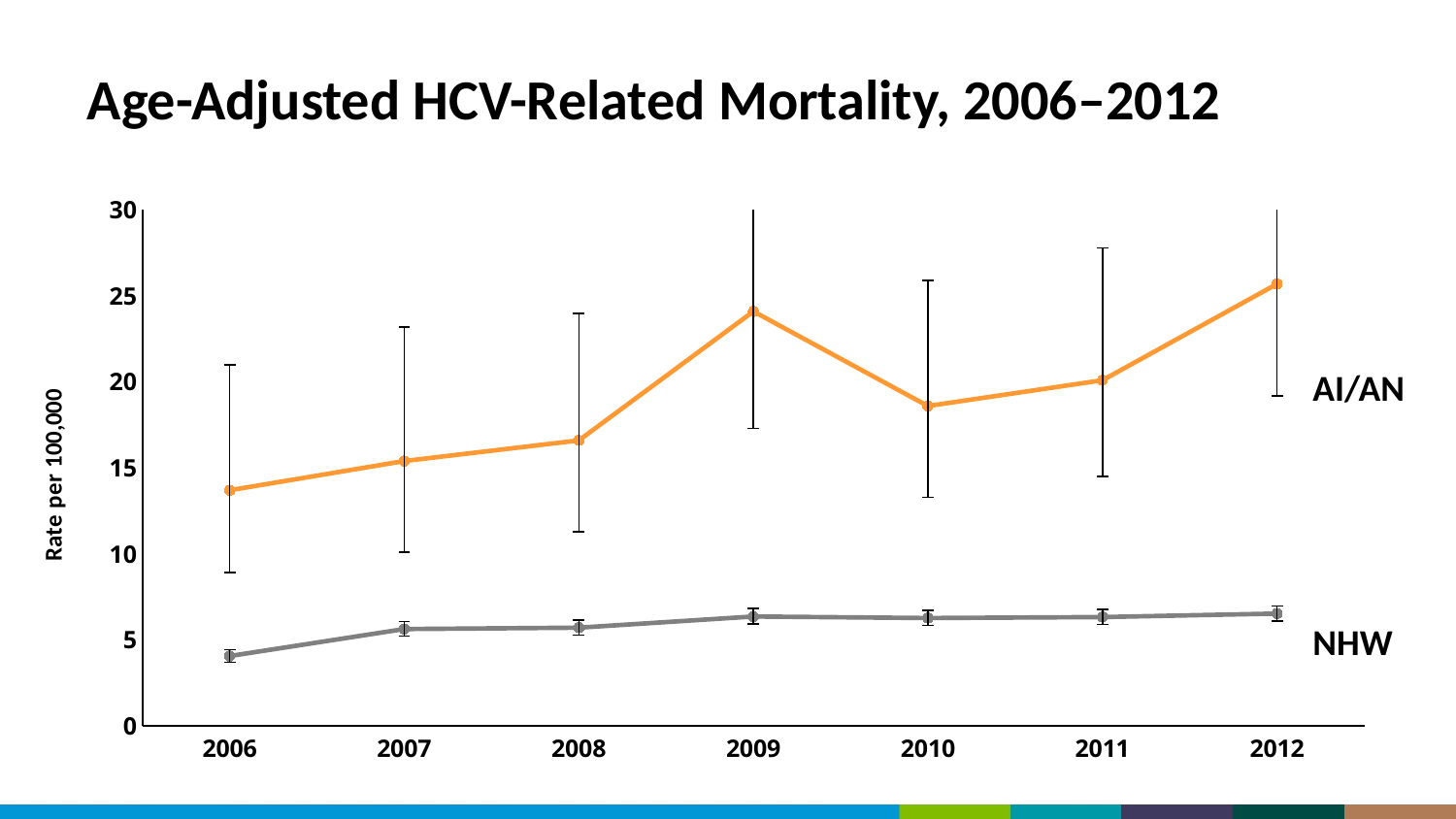
What is the label on the y axis? Rate per 100,000 In which year is the AI/AN rate lowest? 2006 What kind of chart is shown on the slide? line chart How many series are plotted on the chart? 2 How many years are shown along the x axis? 7 In which year is the NHW rate lowest? 2006 Is the AI/AN rate in 2006 greater or less than 15? less Is the NHW rate in 2006 greater or less than 5? less Is the AI/AN rate in 2009 greater or less than 20? greater Which is larger, the AI/AN rate in 2009 or in 2010? 2009 Does the NHW rate rise or fall overall from 2006 to 2012? rise In which year is the AI/AN rate highest? 2012